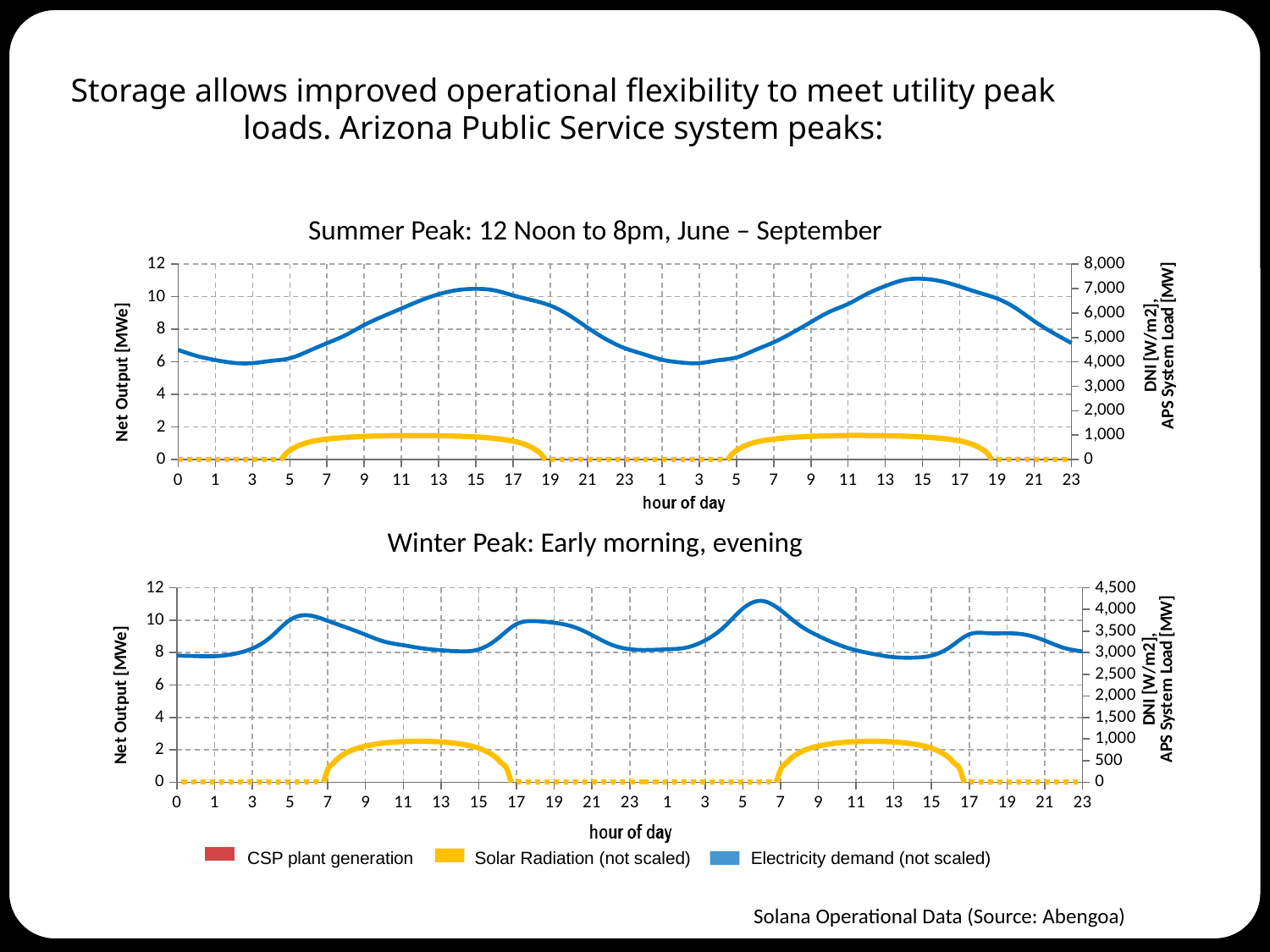
In the Summer Peak chart, what is the Solar Radiation value at hour 1? 0 What kind of chart is the Summer Peak chart? line chart In the Winter Peak chart, is Electricity demand higher at hour 6 or at hour 13? hour 6 In the Summer Peak chart, does the Electricity demand line rise or fall between hour 5 and hour 15? rise What is the title of the top chart? Summer Peak: 12 Noon to 8pm, June – September In the legend, which series is shown in yellow? Solar Radiation (not scaled) In the Winter Peak chart, what is the Solar Radiation value at hour 21? 0 In the Summer Peak chart, is the Electricity demand line at hour 15 greater or less than 8 on the left axis? greater In the Winter Peak chart, is the Solar Radiation line at hour 11 greater or less than 4 on the left axis? less How many series does the legend at the bottom of the slide list? 3 In the Winter Peak chart, does the Solar Radiation line rise or fall between hour 13 and hour 17? fall In the Summer Peak chart, is the Electricity demand line at hour 3 greater or less than 8 on the left axis? less